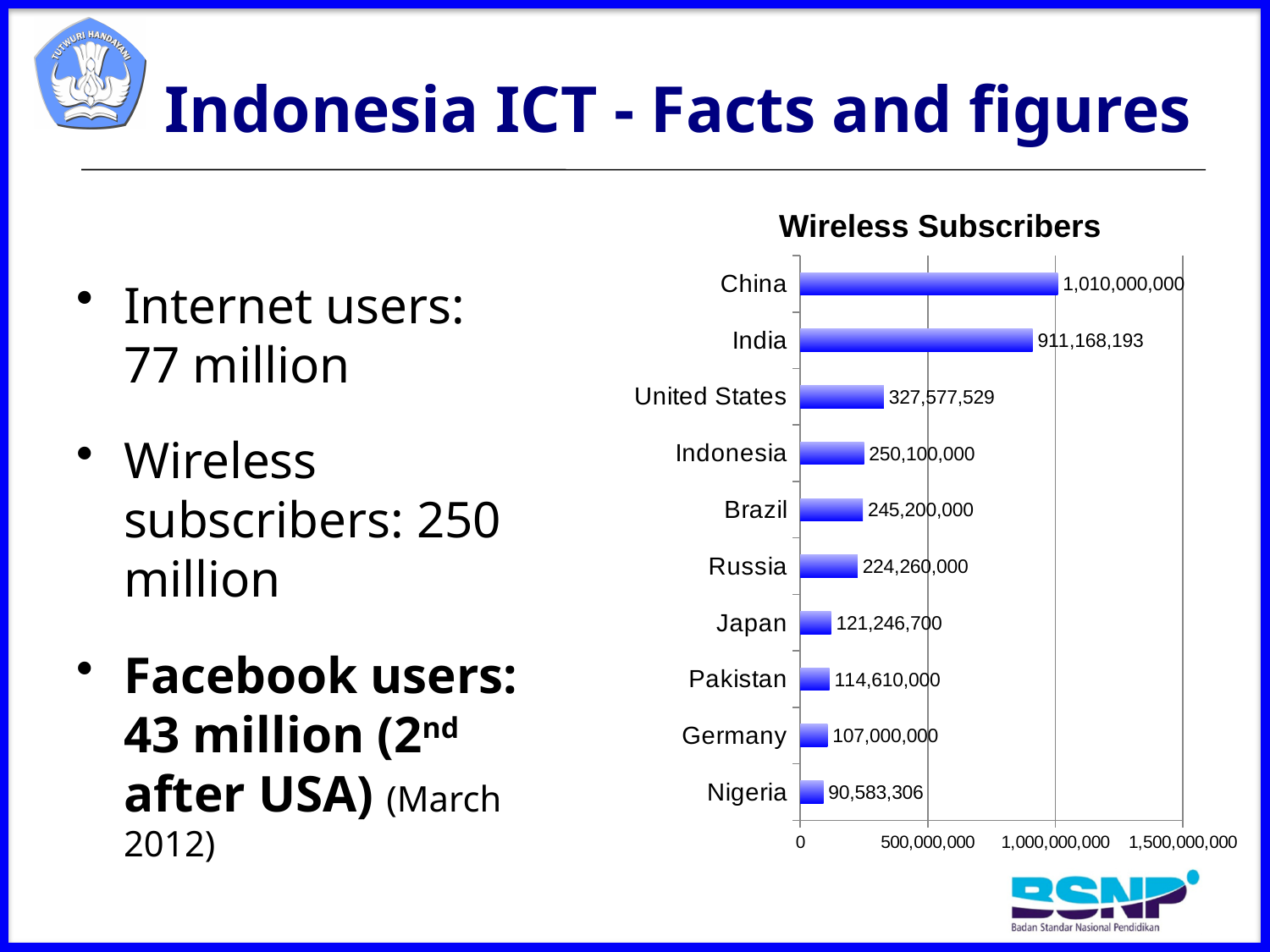
What is the difference between Indonesia's and Brazil's wireless subscribers? 4,900,000 What kind of chart is the Wireless Subscribers chart? bar chart How many countries are shown in the Wireless Subscribers chart? 10 Which country has the lowest number of wireless subscribers in the chart? Nigeria Which has more wireless subscribers, Russia or Japan? Russia What is the value for India in the Wireless Subscribers chart? 911,168,193 Which country has the highest number of wireless subscribers in the chart? China Is the value for the United States greater or less than 500,000,000? less What is the title of the chart on the slide? Wireless Subscribers What is the value for Indonesia in the Wireless Subscribers chart? 250,100,000 What is the value for Nigeria in the Wireless Subscribers chart? 90,583,306 What is the difference between China's and India's wireless subscribers? 98,831,807